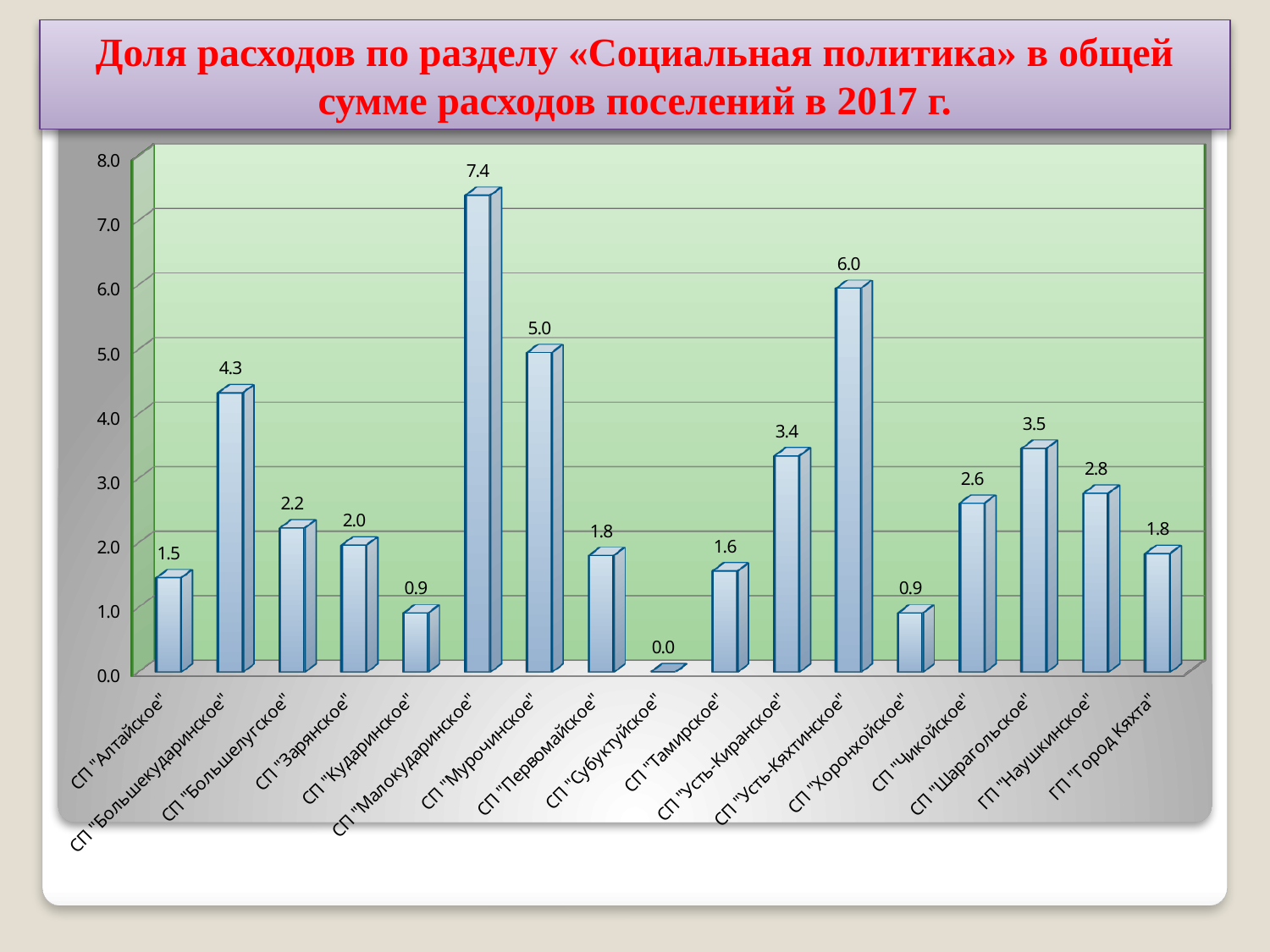
Which category has the lowest value? СП "Субуктуйское" Which is larger, the value for СП "Усть-Киранское" or the value for СП "Чикойское"? СП "Усть-Киранское" What is the value for СП "Малокударинское"? 7.4 What is the value for ГП "Город Кяхта"? 1.8 What is the title of the chart? Доля расходов по разделу «Социальная политика» в общей сумме расходов поселений в 2017 г. What is the value for СП "Усть-Кяхтинское"? 6.0 What is the difference between the values for СП "Малокударинское" and СП "Мурочинское"? 2.4 Is the value for СП "Шарагольское" greater or less than 3.0? greater What is the difference between the values for СП "Большекударинское" and СП "Алтайское"? 2.8 How many categories are shown on the x axis? 17 Which category has the highest value? СП "Малокударинское" What kind of chart is shown on the slide? bar chart